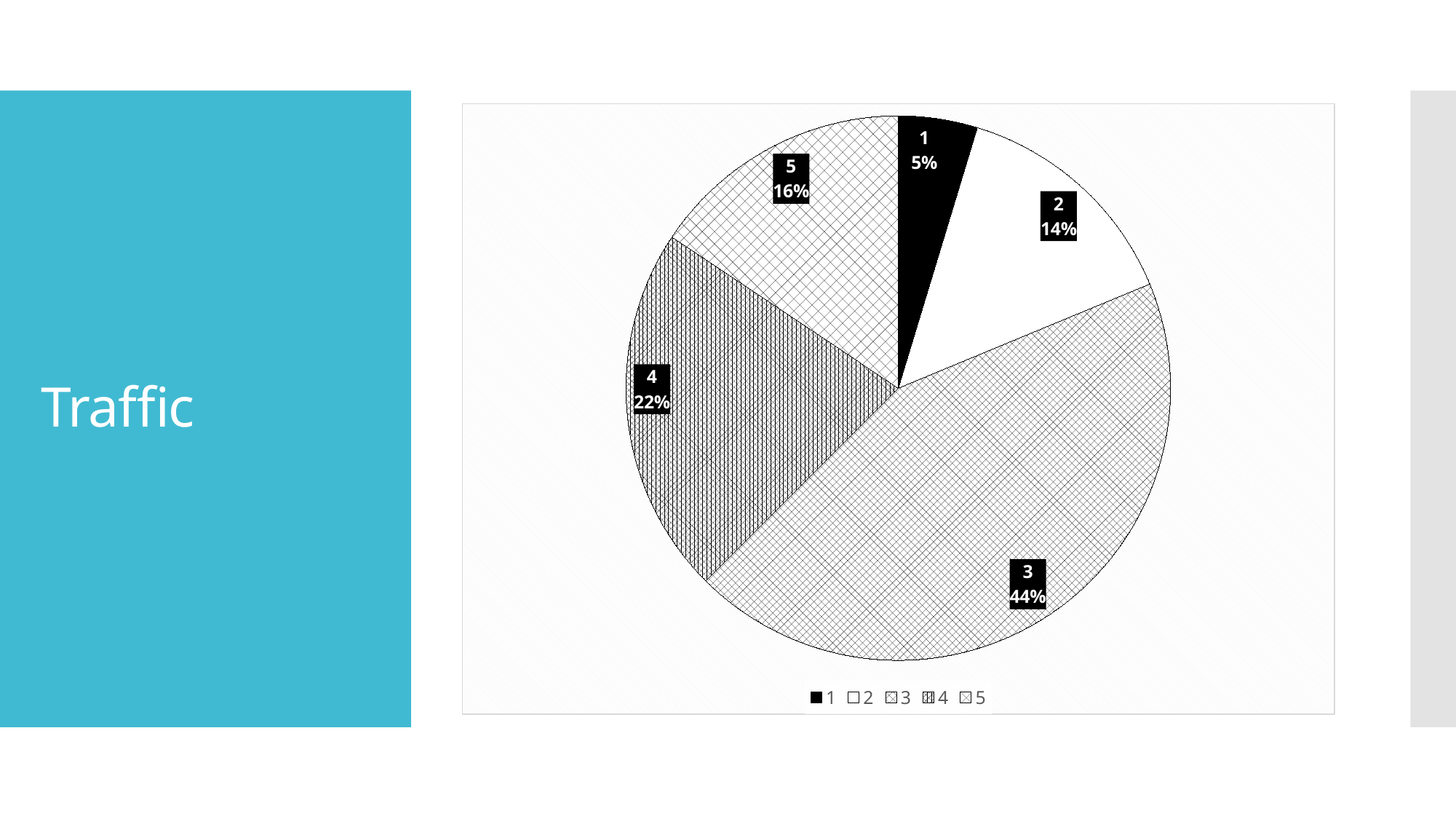
What is the difference in percentage points between category 3 and category 4? 22 What share of the pie does category 2 have? 14% What share of the pie does category 4 have? 22% Which is larger, the slice for category 5 or the slice for category 2? 5 What share of the pie does category 3 have? 44% What kind of chart is shown on the slide? pie chart Which category has the largest slice of the pie? 3 What is the title of the slide containing the pie chart? Traffic How many slices does the pie chart have? 5 Which category has the smallest slice of the pie? 1